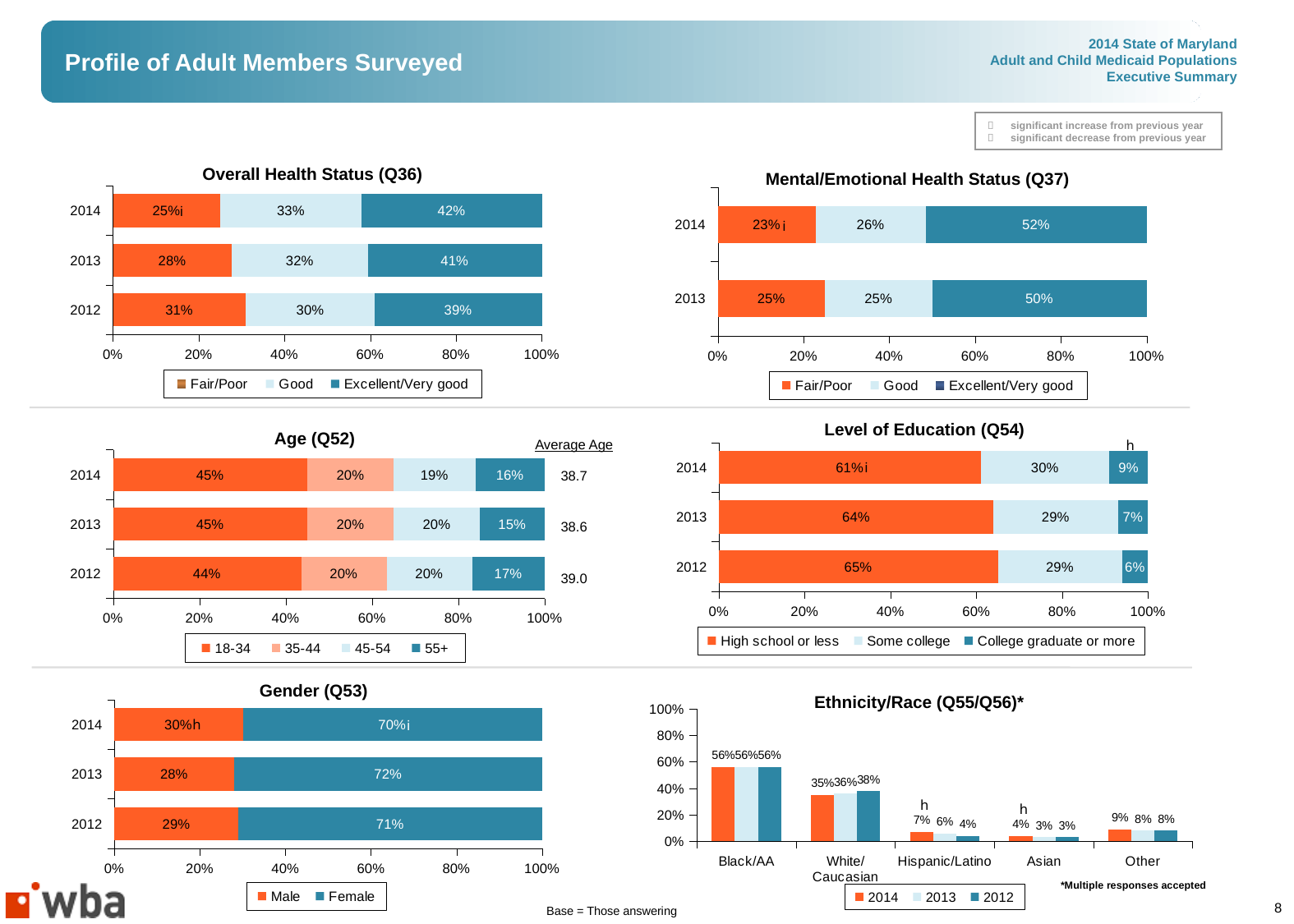
In the Mental/Emotional Health Status (Q37) chart, what is the Good percentage for 2013? 25% How many series does the legend of the Age (Q52) chart list? 4 In the Overall Health Status (Q36) chart, which year has the highest Fair/Poor percentage? 2012 In the Gender (Q53) chart, what percentage of members were female in 2013? 72% How many ethnicity categories are shown on the x axis of the Ethnicity/Race (Q55/Q56) chart? 5 In the Ethnicity/Race (Q55/Q56) chart, which ethnicity category has the highest values? Black/AA In the Overall Health Status (Q36) chart, what percentage of members rated their health Excellent/Very good in 2014? 42% In the Level of Education (Q54) chart, does the College graduate or more percentage rise or fall from 2012 to 2014? rise In the Ethnicity/Race (Q55/Q56) chart, what is the 2014 value for Hispanic/Latino? 7% In the Level of Education (Q54) chart, what percentage had a high school education or less in 2014? 61% In the Age (Q52) chart, what percentage of members were aged 55+ in 2012? 17% In the Mental/Emotional Health Status (Q37) chart, what is the difference between the Excellent/Very good percentages for 2014 and 2013? 2%